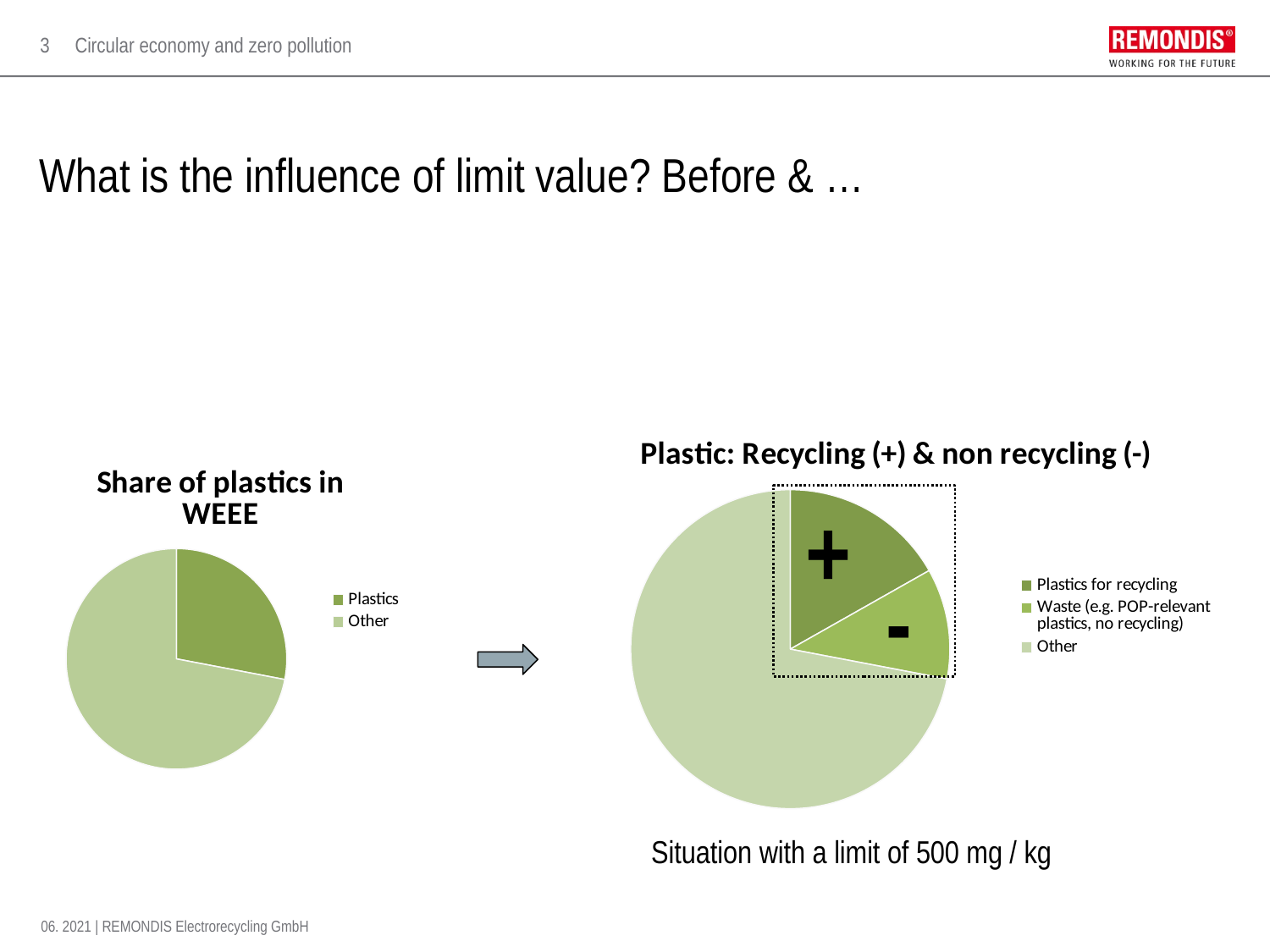
What kind of chart is the "Plastic: Recycling (+) & non recycling (-)" chart? pie chart How many entries does the legend of the "Plastic: Recycling (+) & non recycling (-)" chart list? 3 What kind of chart is the "Share of plastics in WEEE" chart? pie chart In the "Plastic: Recycling (+) & non recycling (-)" chart, which slice is the smallest? Waste (e.g. POP-relevant plastics, no recycling) What is the title of the pie chart on the left of the slide? Share of plastics in WEEE In the "Plastic: Recycling (+) & non recycling (-)" chart, which slice is the largest? Other In the "Plastic: Recycling (+) & non recycling (-)" chart, how many slices does the pie have? 3 In the "Plastic: Recycling (+) & non recycling (-)" chart, which slice is larger: Plastics for recycling or Waste (e.g. POP-relevant plastics, no recycling)? Plastics for recycling In the "Share of plastics in WEEE" chart, how many slices does the pie have? 2 How many entries does the legend of the "Share of plastics in WEEE" chart list? 2 In the "Share of plastics in WEEE" chart, which slice is the smallest? Plastics In the "Share of plastics in WEEE" chart, which slice is the largest? Other